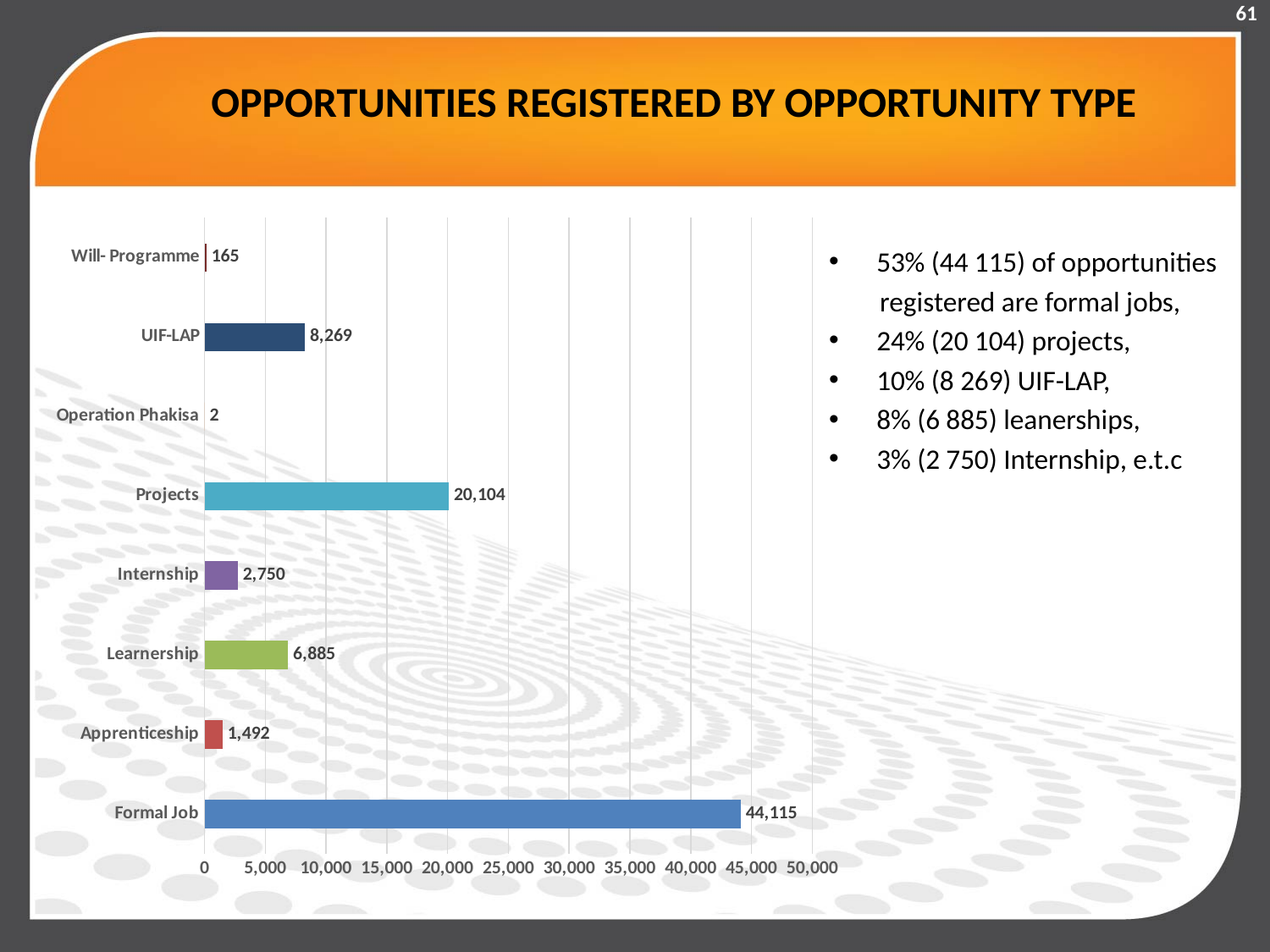
What is the title of the slide? OPPORTUNITIES REGISTERED BY OPPORTUNITY TYPE Which is larger, the value for Internship or the value for Apprenticeship? Internship Which opportunity type has the lowest number of opportunities registered? Operation Phakisa What is the value for Formal Job? 44,115 How many opportunity types are shown in the chart? 8 What is the value for Will- Programme? 165 Which opportunity type has the highest number of opportunities registered? Formal Job What is the difference between the values for UIF-LAP and Learnership? 1,384 What is the value for Operation Phakisa? 2 What is the value for Projects? 20,104 Is the value for Projects greater or less than 25,000? less What kind of chart is shown on the slide? bar chart